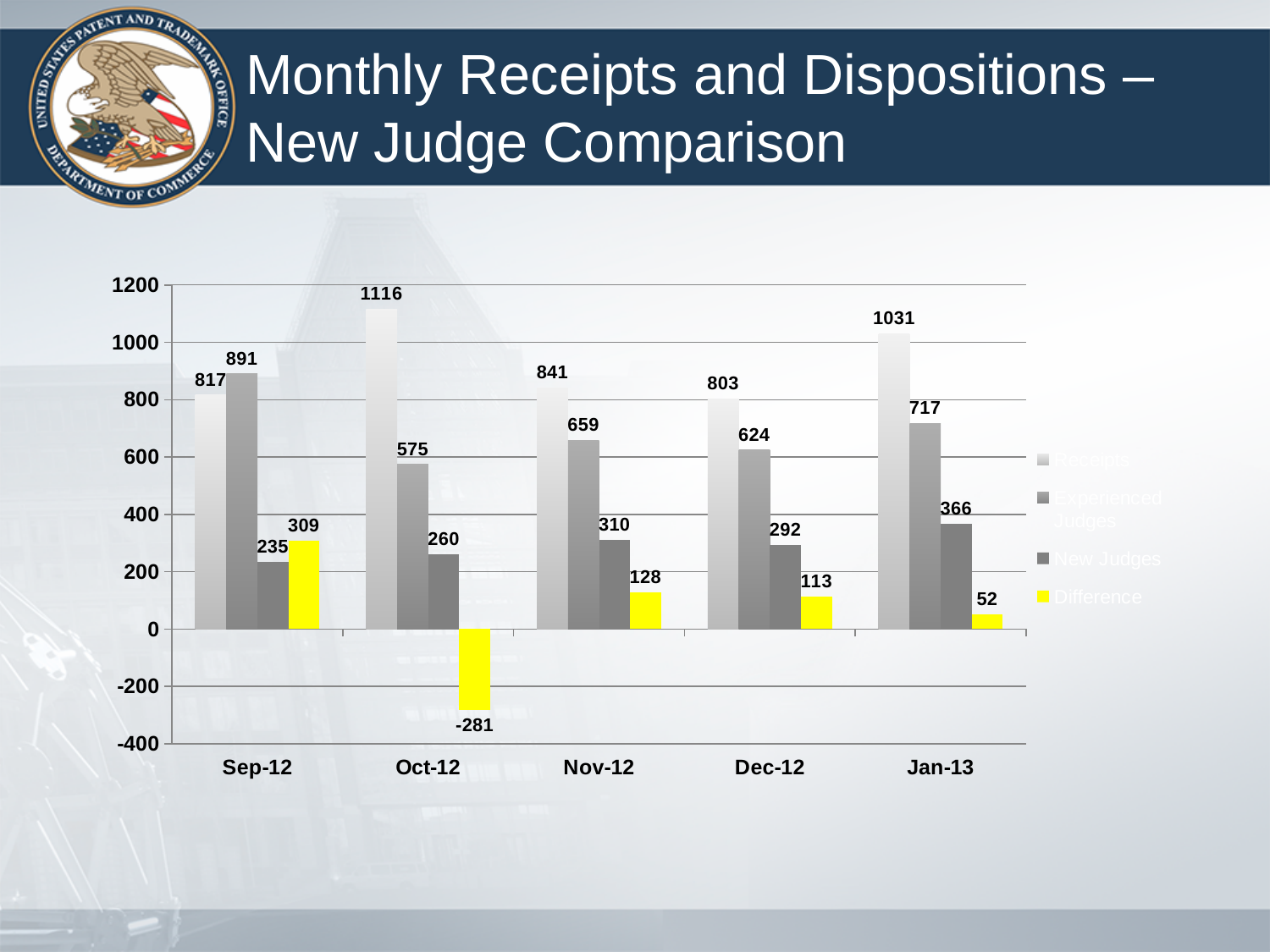
What is the Experienced Judges value for Dec-12? 624 Which month has the highest Receipts value? Oct-12 What is the Receipts value for Oct-12? 1116 What is the difference between the Receipts and Experienced Judges values for Nov-12? 182 What is the Difference value for Oct-12? -281 Which month has the lowest New Judges value? Sep-12 What is the New Judges value for Jan-13? 366 Does the Difference value rise or fall from Nov-12 to Jan-13? Fall Which is larger for Sep-12, Receipts or Experienced Judges? Experienced Judges How many months are shown on the x axis? 5 What kind of chart is shown on the slide? Bar chart How many series does the legend list? 4